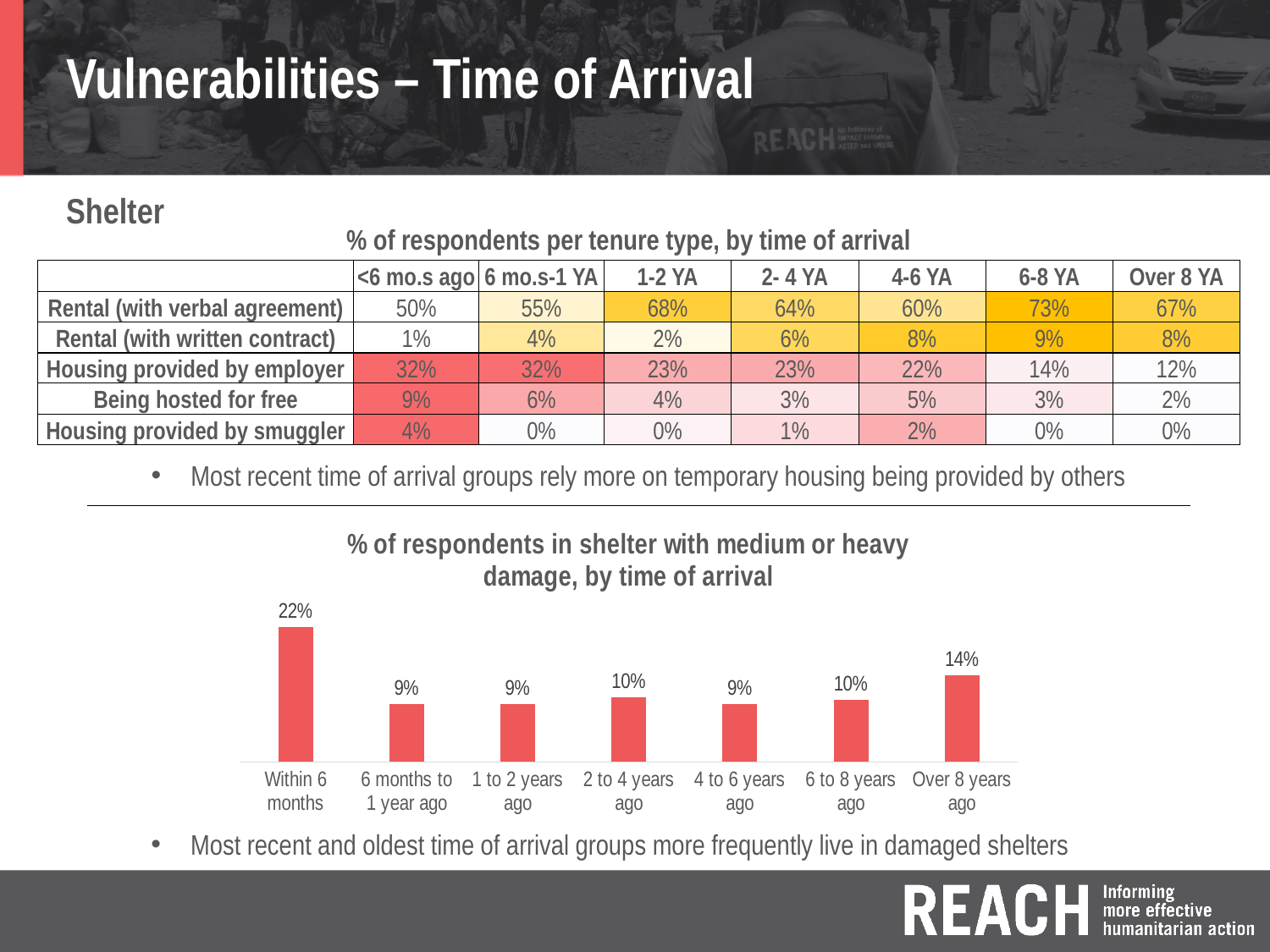
How many time of arrival groups are shown in the bar chart? 7 What is the value for 'Within 6 months' in the bar chart? 22% What is the value for '2 to 4 years ago' in the bar chart? 10% In the bar chart, does the value rise or fall from 'Within 6 months' to '6 months to 1 year ago'? fall What is the title of the bar chart? % of respondents in shelter with medium or heavy damage, by time of arrival What is the difference between the values for 'Within 6 months' and 'Over 8 years ago' in the bar chart? 8 percentage points What is the value for '4 to 6 years ago' in the bar chart? 9% What kind of chart is shown on the slide? bar chart What is the value for 'Over 8 years ago' in the bar chart? 14% Which time of arrival group has the highest value in the bar chart? Within 6 months In the bar chart, which is larger: the value for 'Over 8 years ago' or the value for '1 to 2 years ago'? Over 8 years ago What is the difference between the values for 'Over 8 years ago' and '6 to 8 years ago' in the bar chart? 4 percentage points